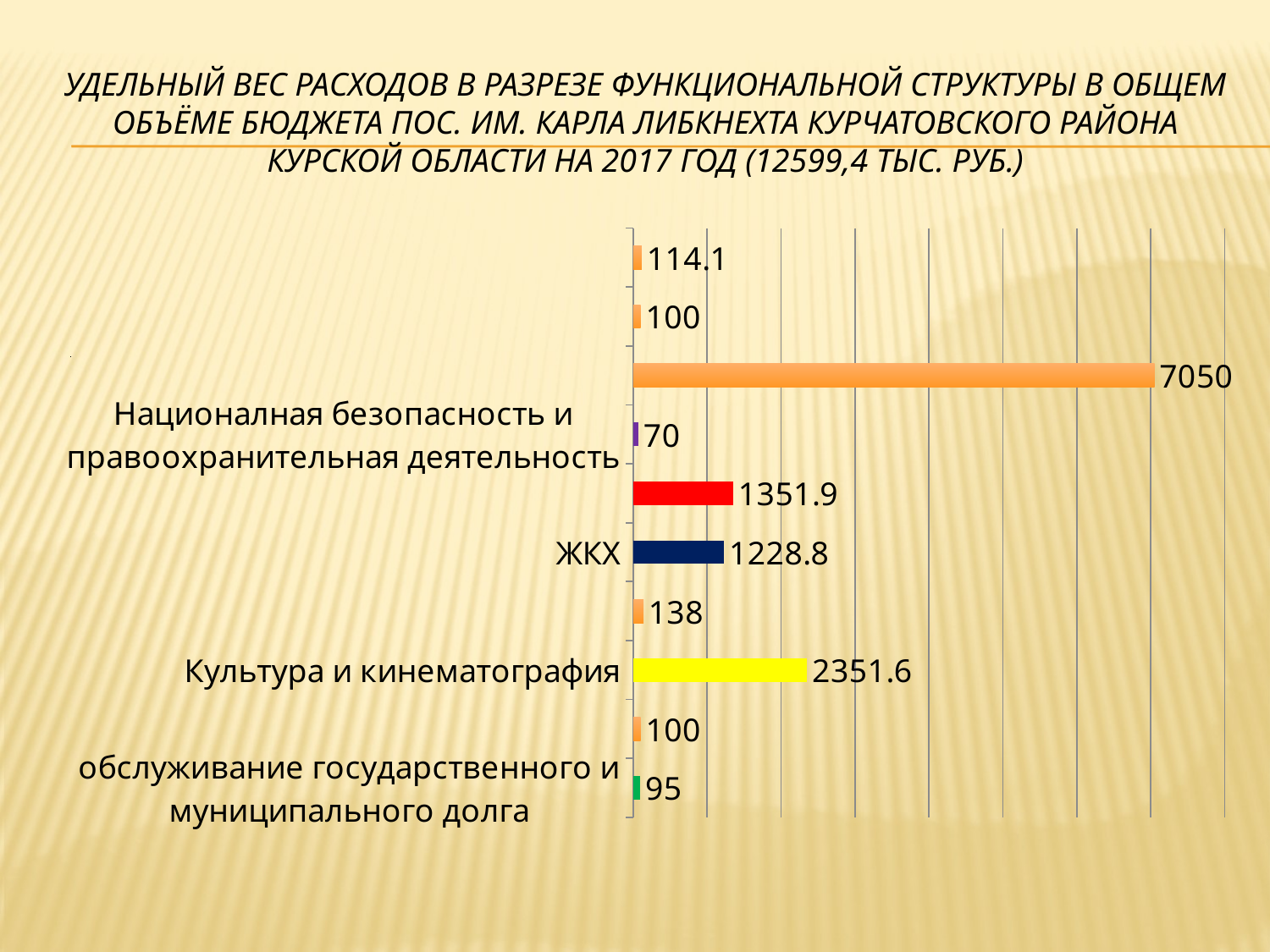
What is the value for обслуживание государственного и муниципального долга? 95 What is the largest value shown on the chart? 7050 What is the value for ЖКХ? 1228.8 How many bars are plotted on the chart? 10 Which labelled category has the lowest value on the chart? Националная безопасность и правоохранительная деятельность What is the value for Культура и кинематография? 2351.6 What is the difference between the values for Культура и кинематография and ЖКХ? 1122.8 What kind of chart is shown on the slide? bar chart What is the value for Националная безопасность и правоохранительная деятельность? 70 What colour is the bar for Культура и кинематография? yellow What colour is the bar for ЖКХ? dark blue Which is larger, the value for ЖКХ or the value for Культура и кинематография? Культура и кинематография